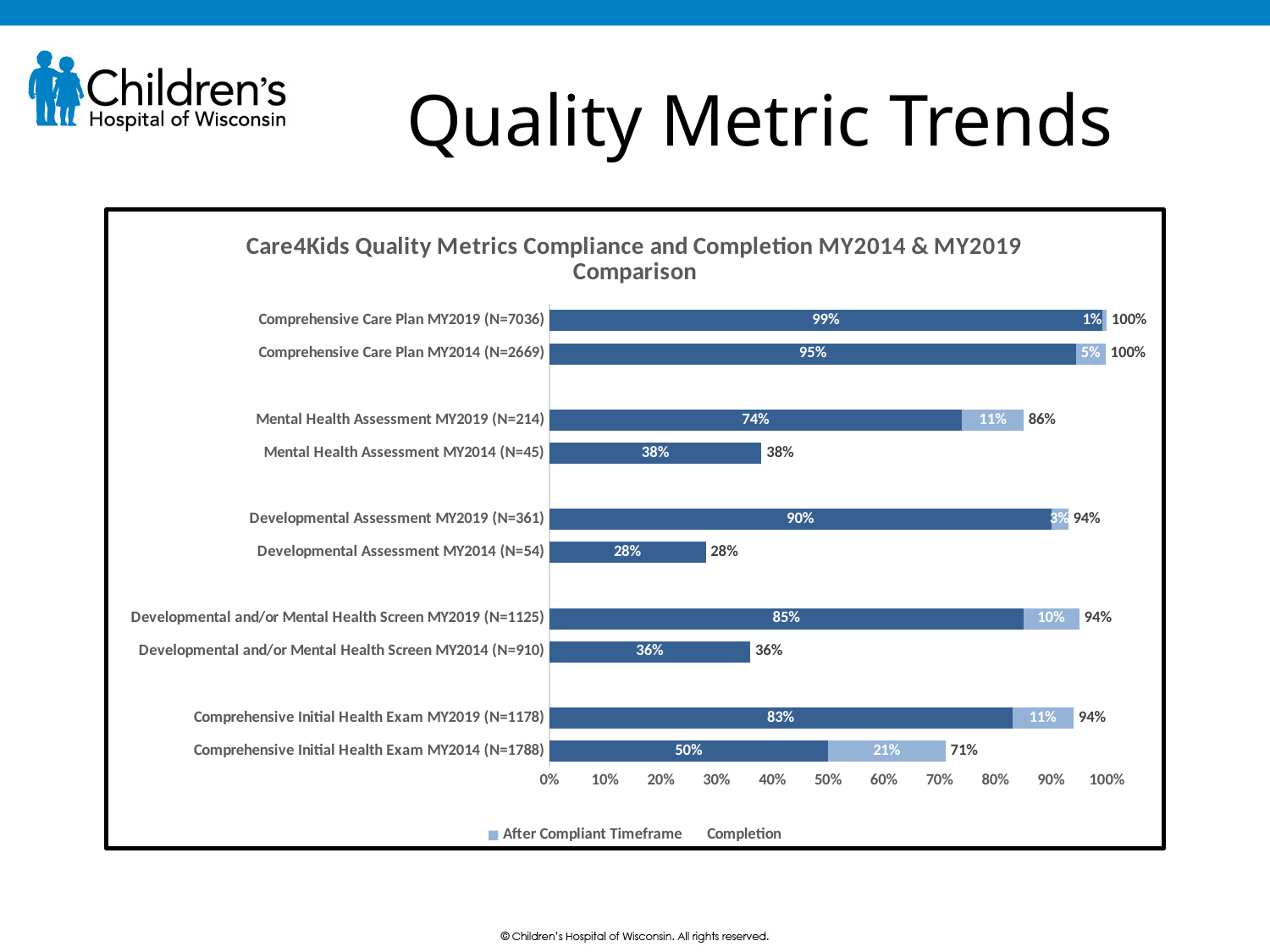
Which is larger: the Completion value for Comprehensive Care Plan MY2014 (N=2669) or for Developmental Assessment MY2019 (N=361)? Comprehensive Care Plan MY2014 (N=2669) Which category has the lowest total value? Developmental Assessment MY2014 (N=54) What is the Completion value for Mental Health Assessment MY2019 (N=214)? 86% What is the After Compliant Timeframe value for Comprehensive Initial Health Exam MY2014 (N=1788)? 21% What is the total shown at the end of the Mental Health Assessment MY2019 (N=214) bar? 86% By how many percentage points does the Completion value for Developmental Assessment MY2019 (N=361) exceed that for Developmental Assessment MY2014 (N=54)? 66 percentage points How many categories (bars) are plotted in the chart? 10 How many series does the chart legend list? 2 What is the title of the chart? Care4Kids Quality Metrics Compliance and Completion MY2014 & MY2019 Comparison What is the total shown at the end of the Comprehensive Initial Health Exam MY2014 (N=1788) bar? 71% What kind of chart is shown on the slide? Stacked horizontal bar chart